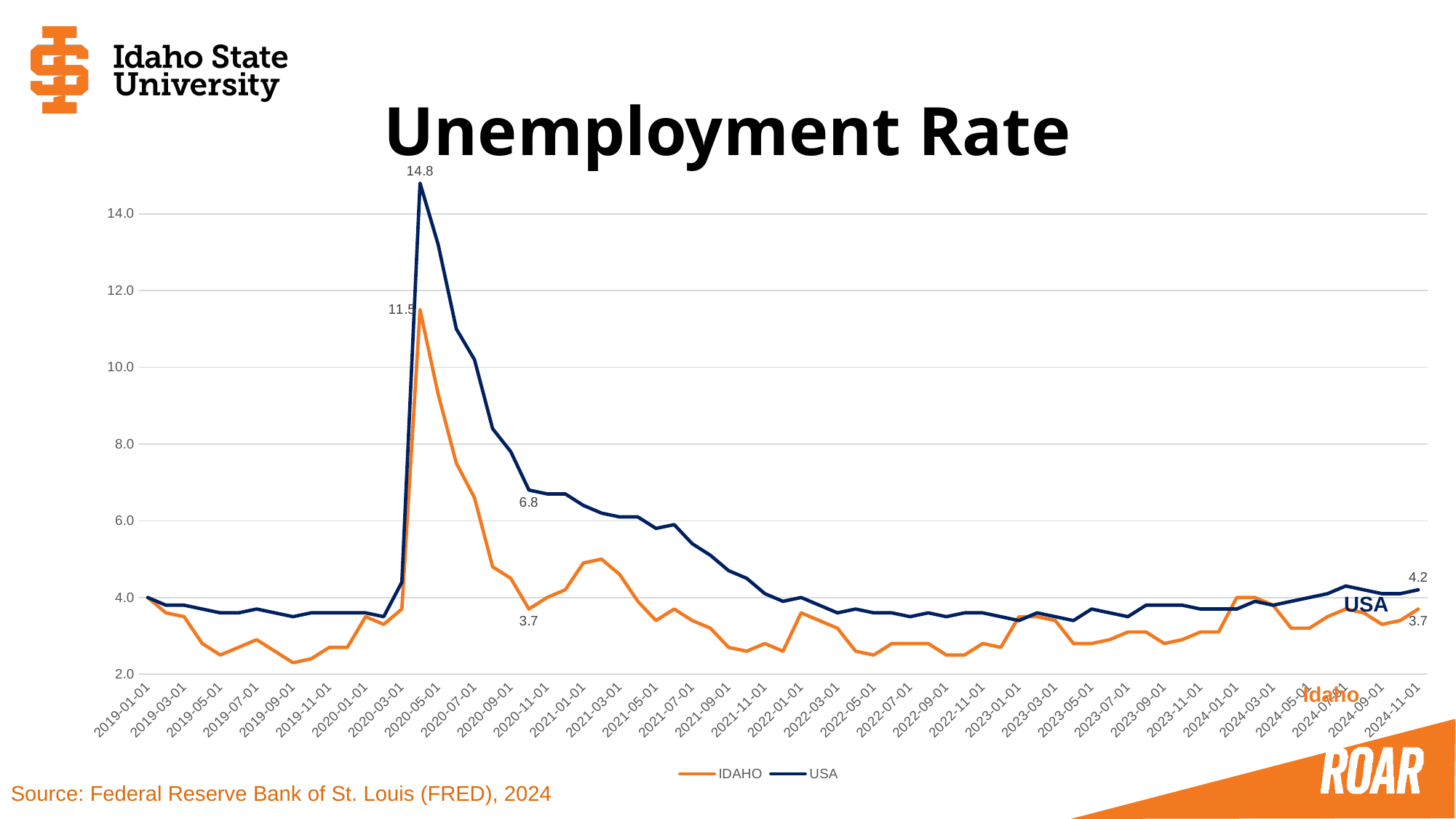
Does the USA line rise or fall between 2020-05-01 and 2022-01-01? fall What is the peak value labeled on the IDAHO line in 2020? 11.5 At the 2020 peak, which series has the higher unemployment rate, IDAHO or USA? USA What is the value labeled at the end of the USA line (2024-11-01)? 4.2 What is the title of the chart? Unemployment Rate What is the highest value labeled on the USA line? 14.8 How many series does the legend list? 2 Is the IDAHO value at 2019-09-01 greater or less than 4.0? less What is the difference between the final USA value (4.2) and the final IDAHO value (3.7)? 0.5 What is the value labeled at the end of the IDAHO line (2024-11-01)? 3.7 What is the difference between the USA peak (14.8) and the IDAHO peak (11.5)? 3.3 What type of chart is shown on the slide? line chart